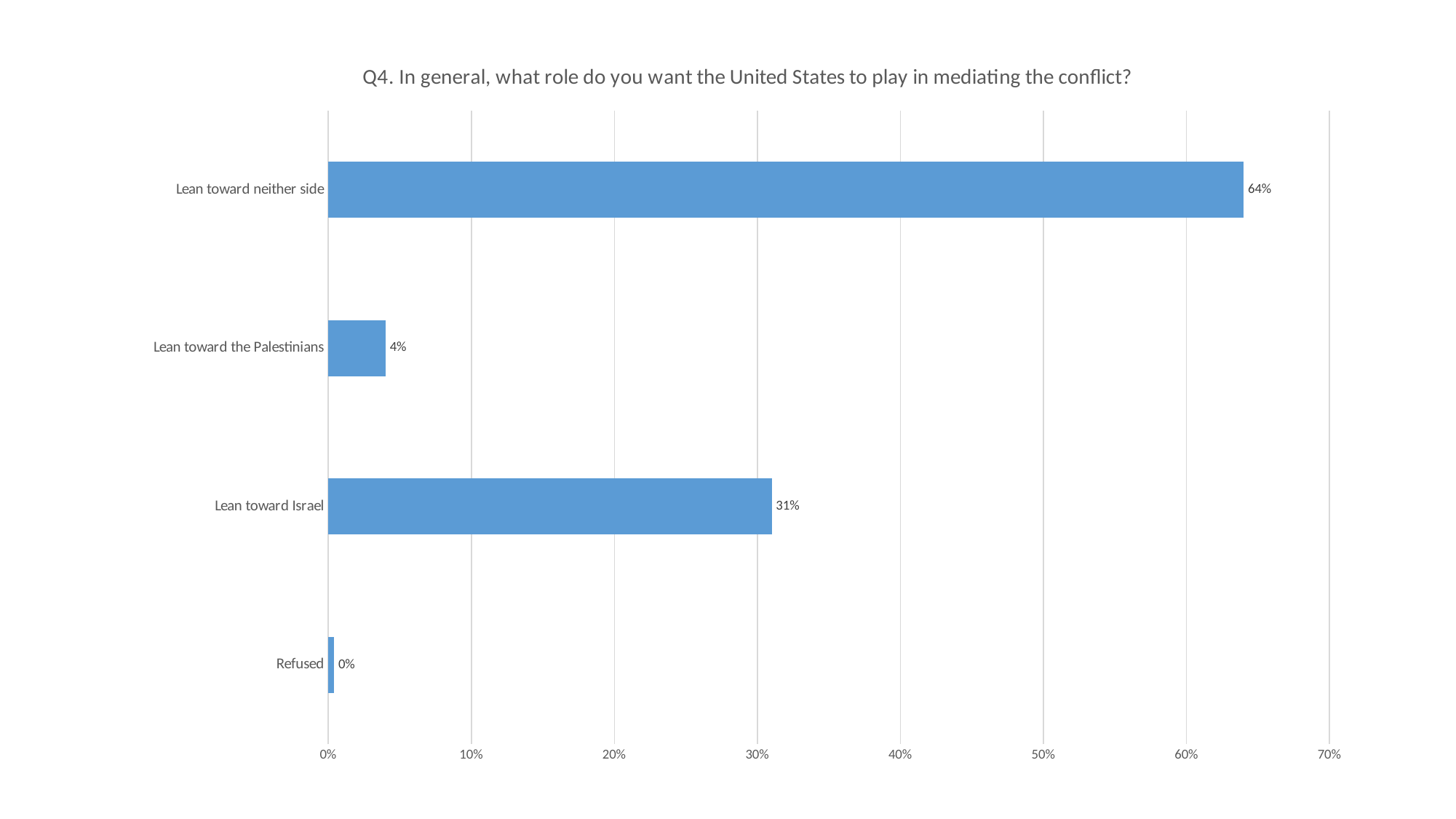
What is the value shown for 'Refused'? 0% Which category has the highest value? Lean toward neither side What kind of chart is shown on the slide? Bar chart What percentage of respondents want the United States to lean toward neither side? 64% What is the value shown for 'Lean toward the Palestinians'? 4% Is the value for 'Lean toward neither side' greater or less than 60%? greater What is the title of the chart? Q4. In general, what role do you want the United States to play in mediating the conflict? Which category has the lowest value? Refused Which is larger: 'Lean toward Israel' or 'Lean toward the Palestinians'? Lean toward Israel What is the value shown for 'Lean toward Israel'? 31% What is the difference between 'Lean toward neither side' and 'Lean toward Israel'? 33 percentage points How many categories are shown in the chart? 4